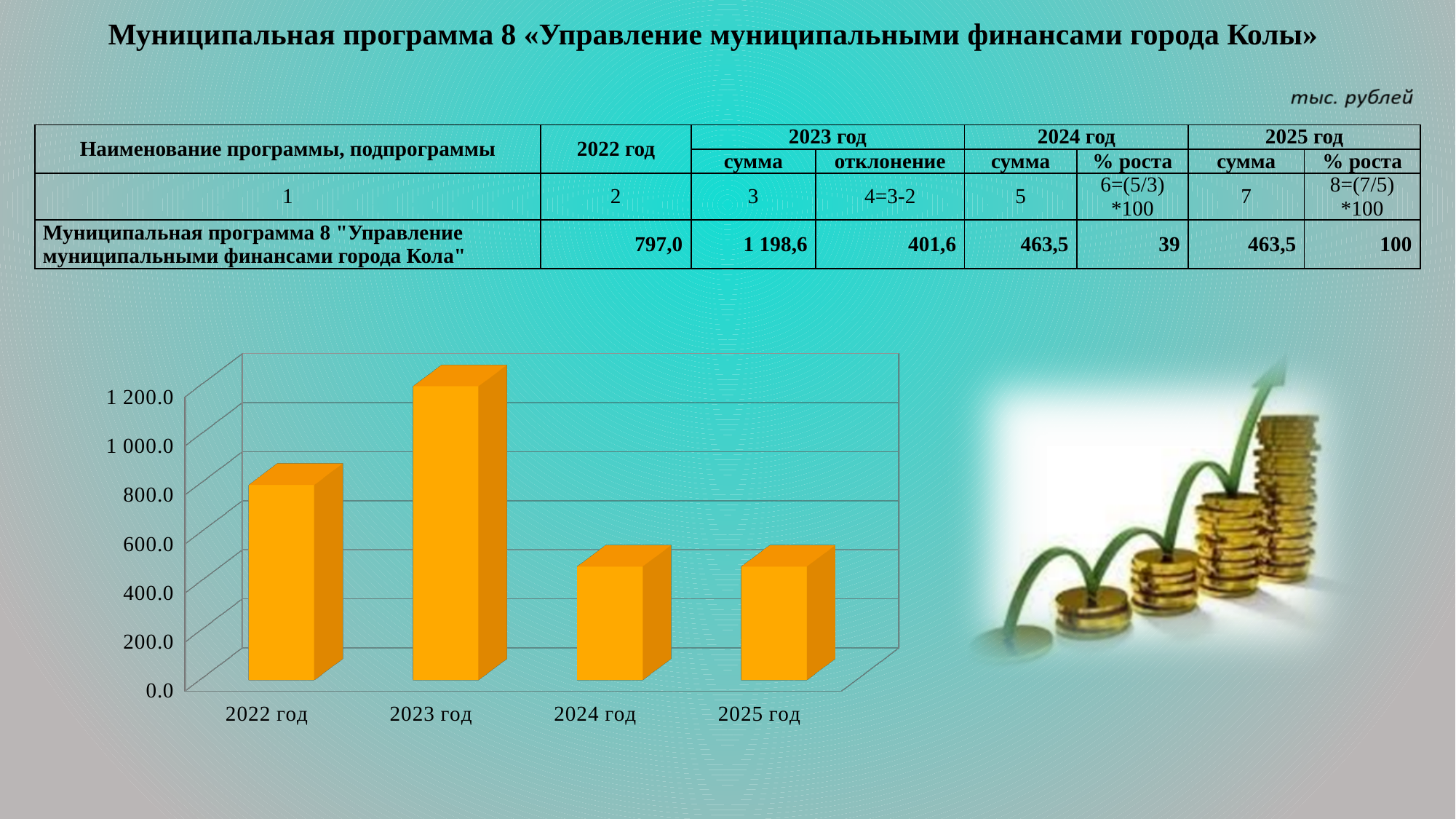
Which bar is taller, 2022 год or 2023 год? 2023 год Which year has the highest bar in the chart? 2023 год According to the table on the slide, what is the value for 2023 год (сумма)? 1 198,6 Which bar is taller, 2022 год or 2024 год? 2022 год Is the value for 2022 год greater or less than 600.0? greater How many categories (years) are shown on the x axis of the bar chart? 4 Is the value for 2023 год greater or less than 1 000.0? greater Is the value for 2024 год greater or less than 600.0? less What kind of chart is shown on the slide? bar chart According to the table on the slide, what is the value for 2022 год? 797,0 What is the highest value shown on the vertical axis of the chart? 1 200.0